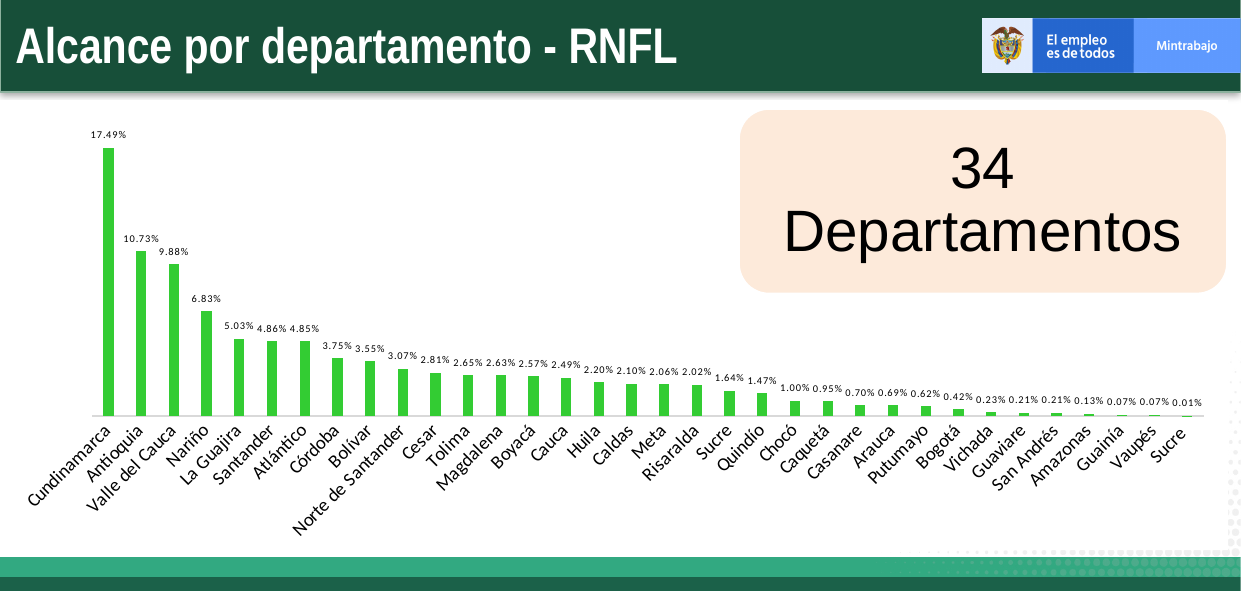
What is the difference between the values for Cundinamarca and Antioquia? 6.76% Which is larger, the value for Córdoba or the value for Bolívar? Córdoba What is the value for Amazonas? 0.13% What is the difference between the values for Antioquia and Valle del Cauca? 0.85% What is the value for Cundinamarca? 17.49% Which department has the highest value? Cundinamarca What is the value for Nariño? 6.83% What is the value for Chocó? 1.00% What is the value for Bogotá? 0.42% What kind of chart is shown on the slide? Bar chart How many departments are shown in the chart? 34 Do the values rise or fall from left to right along the x axis? Fall